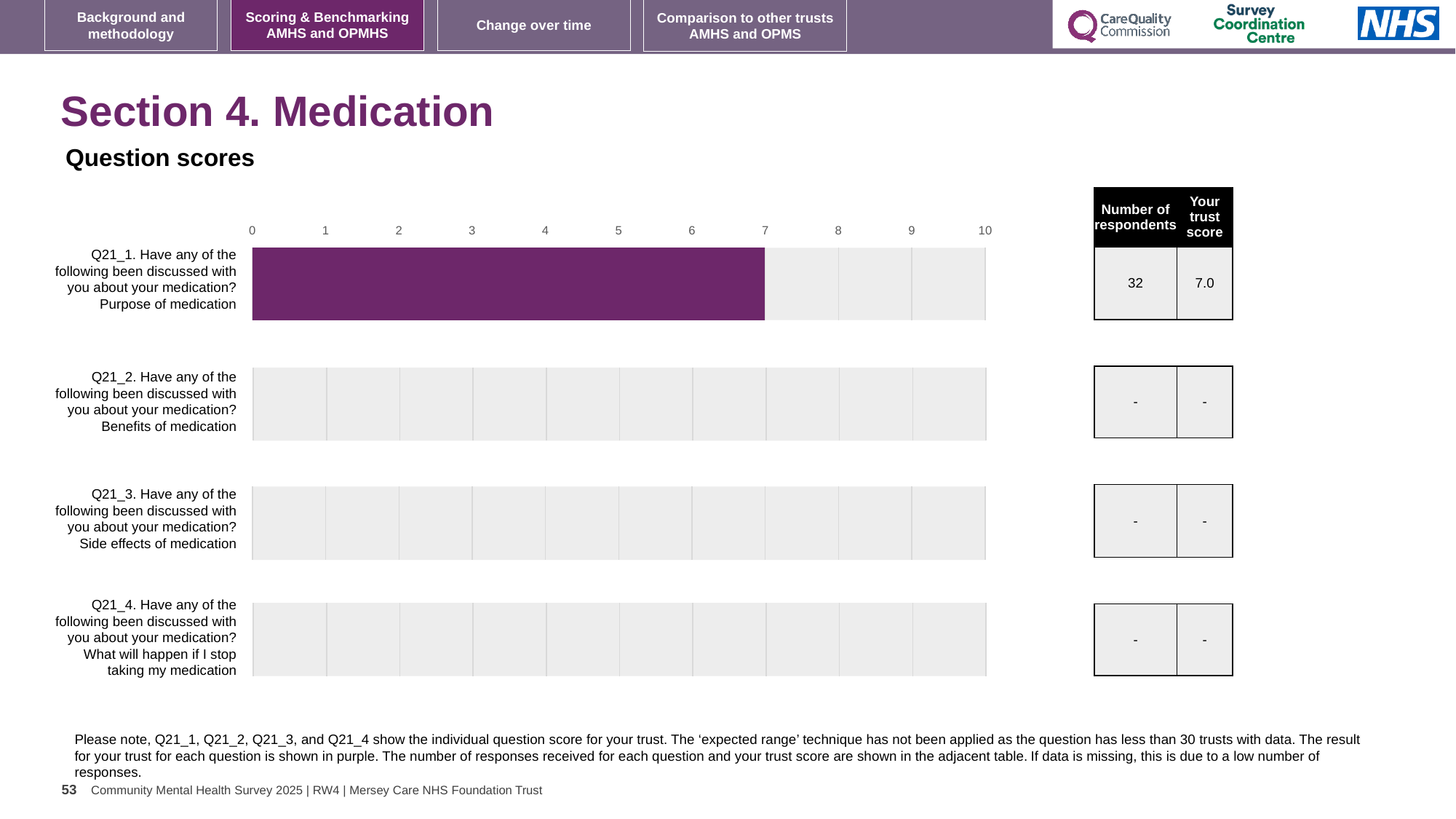
Is the value for Q21_1 (Purpose of medication) greater or less than 5? greater How many respondents answered Q21_1 (Purpose of medication)? 32 How many questions (categories) are listed on the chart? 4 How many of the four questions have a bar plotted on the chart? 1 What kind of chart is shown on the slide? bar chart Is the value for Q21_1 (Purpose of medication) greater or less than 8? less Which question has the highest score shown on the chart? Q21_1. Purpose of medication What is the trust score shown for Q21_2 (Benefits of medication)? - What is the trust score for Q21_1 (Purpose of medication)? 7.0 What is the maximum value on the chart's x axis? 10 What colour is the bar showing the trust's result? purple What is the number of respondents shown for Q21_4 (What will happen if I stop taking my medication)? -